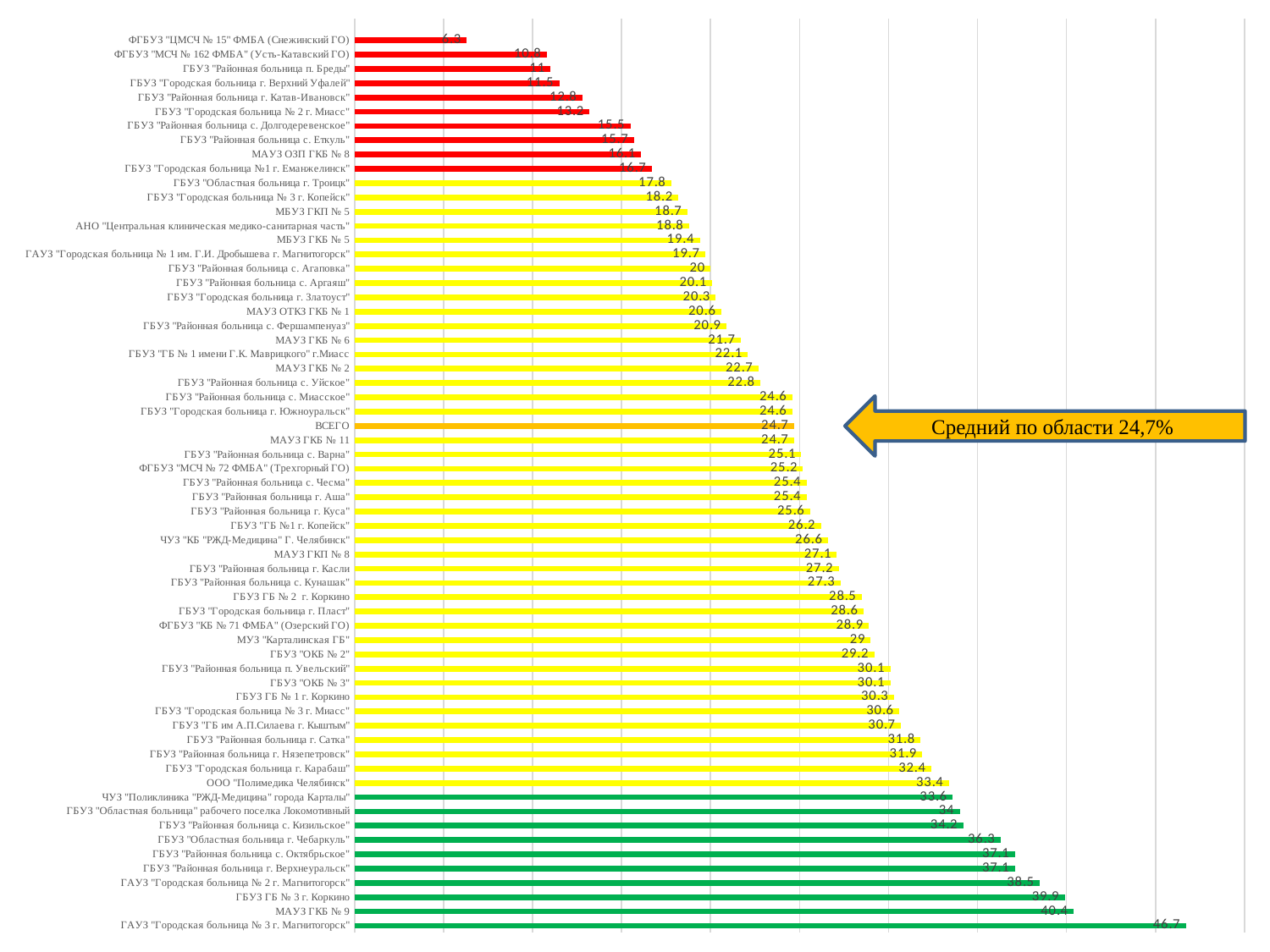
What is the value for МАУЗ ГКБ № 9? 40.4 What kind of chart is shown on the slide? bar chart Which organisation has the lowest value on the chart? ФГБУЗ "ЦМСЧ № 15" ФМБА (Снежинский ГО) What is the value for ГБУЗ "Областная больница г. Троицк"? 17.8 Which has a larger value: ГБУЗ "Районная больница г. Сатка" or ГБУЗ "Городская больница г. Златоуст"? ГБУЗ "Районная больница г. Сатка" What regional average value does the callout on the chart state? 24,7% What colour are the bars for the organisations with the highest values at the bottom of the chart? green Which organisation has the highest value on the chart? ГАУЗ "Городская больница № 3 г. Магнитогорск" What is the value for ГБУЗ "Районная больница с. Агаповка"? 20 What is the value for ГАУЗ "Городская больница № 3 г. Магнитогорск"? 46.7 What is the value for ВСЕГО? 24.7 What is the difference between the values for ГАУЗ "Городская больница № 3 г. Магнитогорск" and МАУЗ ГКБ № 9? 6.3